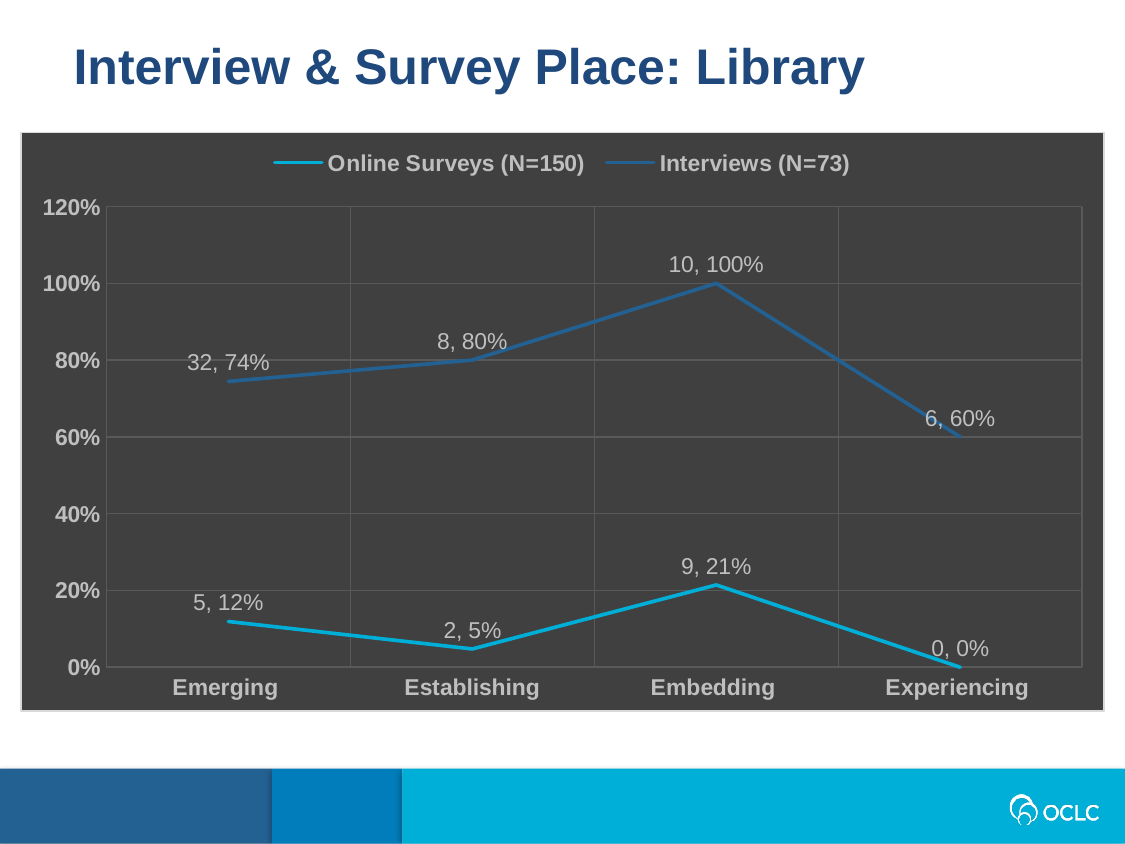
What is the percentage value for Interviews (N=73) at the Embedding stage? 100% How many series does the legend list? 2 What kind of chart is shown on the slide? line chart What is the difference in percentage points between Interviews (N=73) and Online Surveys (N=150) at the Establishing stage? 75 At which stage is the Interviews (N=73) percentage highest? Embedding How many stages are shown on the x axis? 4 What is the percentage value for Interviews (N=73) at the Experiencing stage? 60% What is the percentage value for Online Surveys (N=150) at the Emerging stage? 12% Does the Interviews (N=73) line rise or fall from Embedding to Experiencing? fall At which stage is the Online Surveys (N=150) percentage lowest? Experiencing Which series has the larger value at the Emerging stage, Online Surveys (N=150) or Interviews (N=73)? Interviews (N=73) What is the count shown in the data label for Online Surveys (N=150) at the Embedding stage? 9